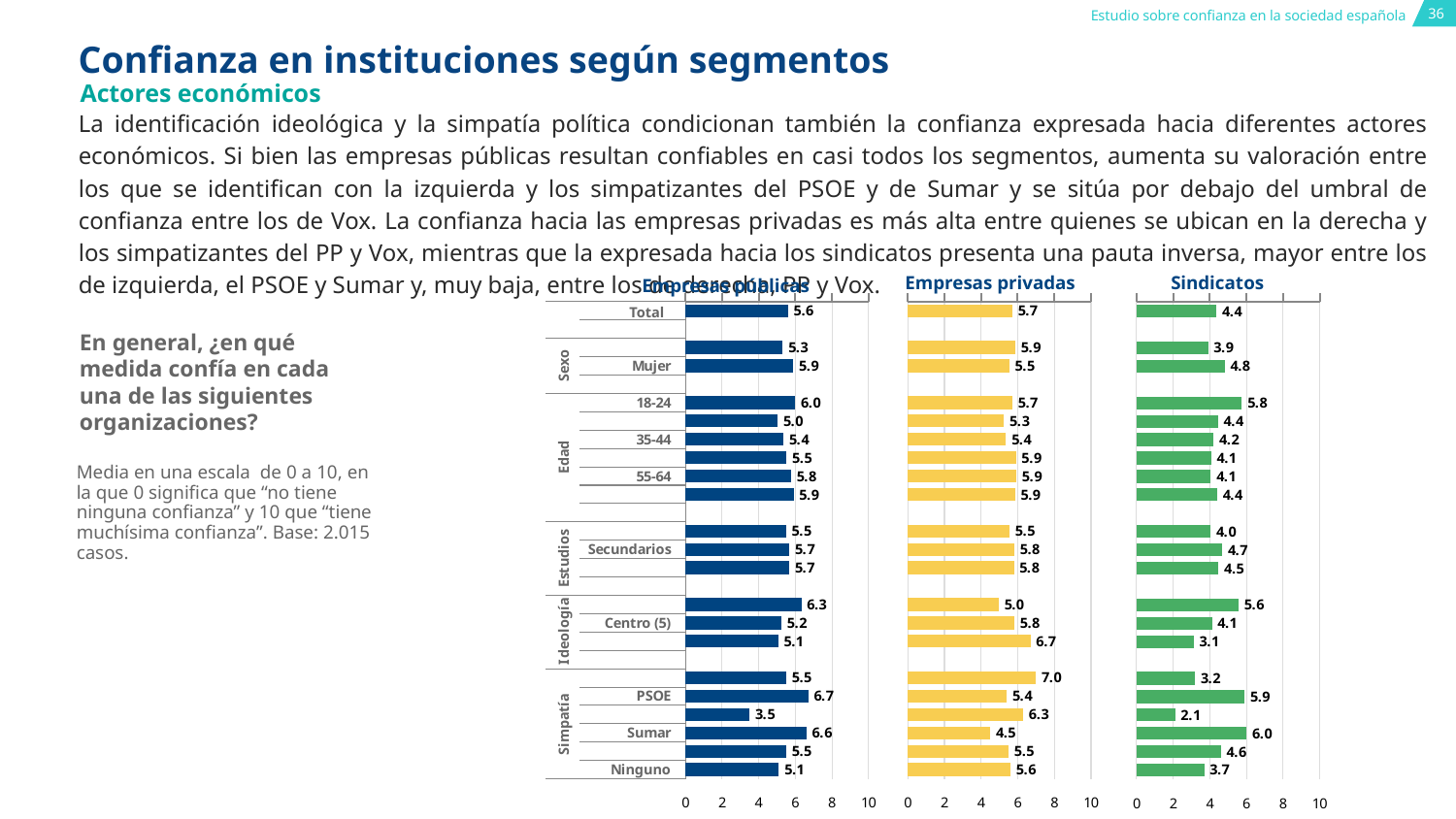
In the Sindicatos chart, which is larger, the value for 18-24 or the value for 55-64? 18-24 In the Empresas privadas chart, what is the highest value shown? 7.0 In the leftmost chart, what is the difference between the values for PSOE and Ninguno? 1.6 In the Sindicatos chart, which labelled category has the lowest value? Ninguno What type of chart is used on this slide? Bar chart In the Empresas privadas chart, what is the value for Centro (5)? 5.8 In the Empresas privadas chart, what is the value for Mujer? 5.5 In the Sindicatos chart, what is the value for Sumar? 6.0 In the Sindicatos chart, what is the value for Total? 4.4 In the leftmost chart, what is the value for PSOE? 6.7 How many charts are shown on the slide? 3 In the Empresas privadas chart, what is the value for Ninguno? 5.6